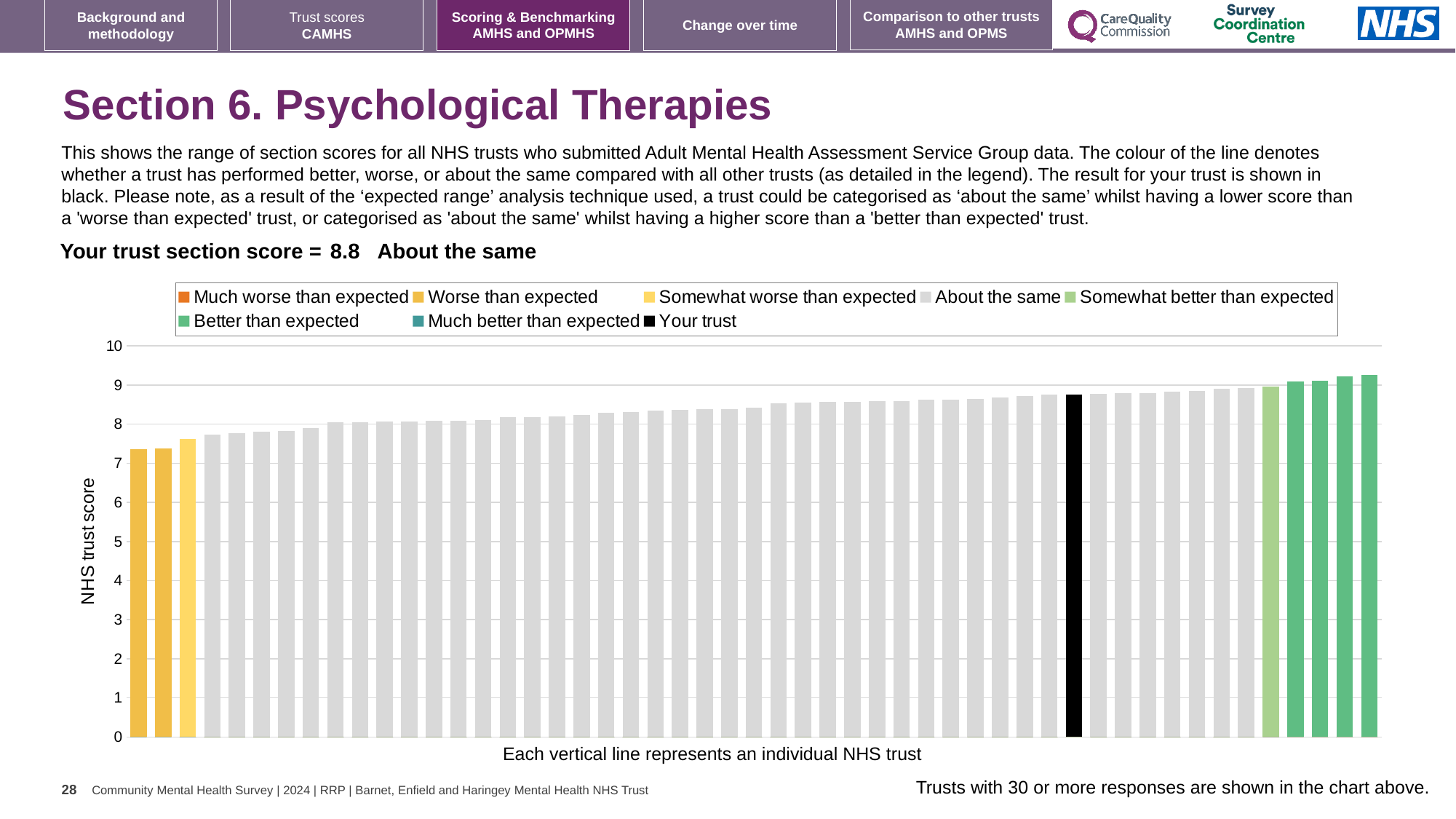
What colour is the bar representing your trust? black How many entries does the chart legend list? 8 Is the value of the leftmost bar greater or less than 8? less What is the label on the vertical axis of the chart? NHS trust score How many bars are coloured in the 'Better than expected' colour? 4 How many bars are coloured in the 'Worse than expected' colour? 2 Is the value of the rightmost bar greater or less than 9? greater What is the section score for your trust shown on the slide? 8.8 Which performance category is your trust placed in for this section? About the same Is the value of the black 'Your trust' bar greater or less than 8? greater What kind of chart is shown on the slide? bar chart Do the bar values rise or fall from left to right across the chart? rise